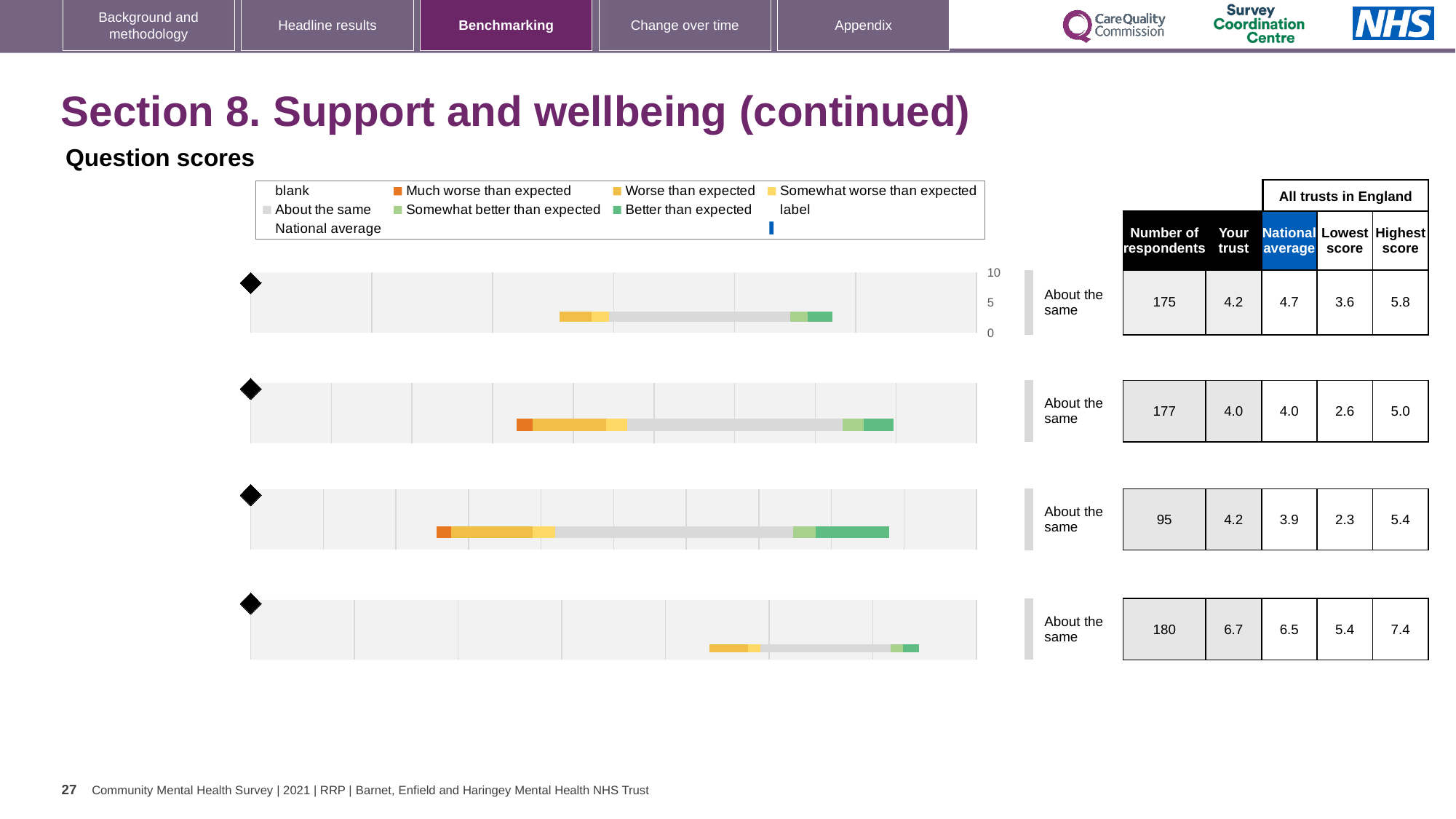
Which chart row has the highest 'Your trust' score? the fourth (bottom) row What kind of chart is used to show the question scores on this slide? bar chart For the third chart row, which is larger: the 'Your trust' score or the national average? Your trust For the third chart row, how many respondents are listed? 95 Which chart row has the lowest 'Lowest score' value among all trusts in England? the third row For the first (top) chart row, what is the 'Your trust' score shown in the table? 4.2 For the first chart row, what is the difference between the national average and the 'Your trust' score? 0.5 For the fourth (bottom) chart row, what is the national average score? 6.5 How many benchmarking charts are shown on the slide? 4 In the legend, what colour represents 'Much worse than expected'? orange What benchmark category is shown next to each of the four charts? About the same For the fourth chart row, what is the difference between the highest score and the lowest score? 2.0